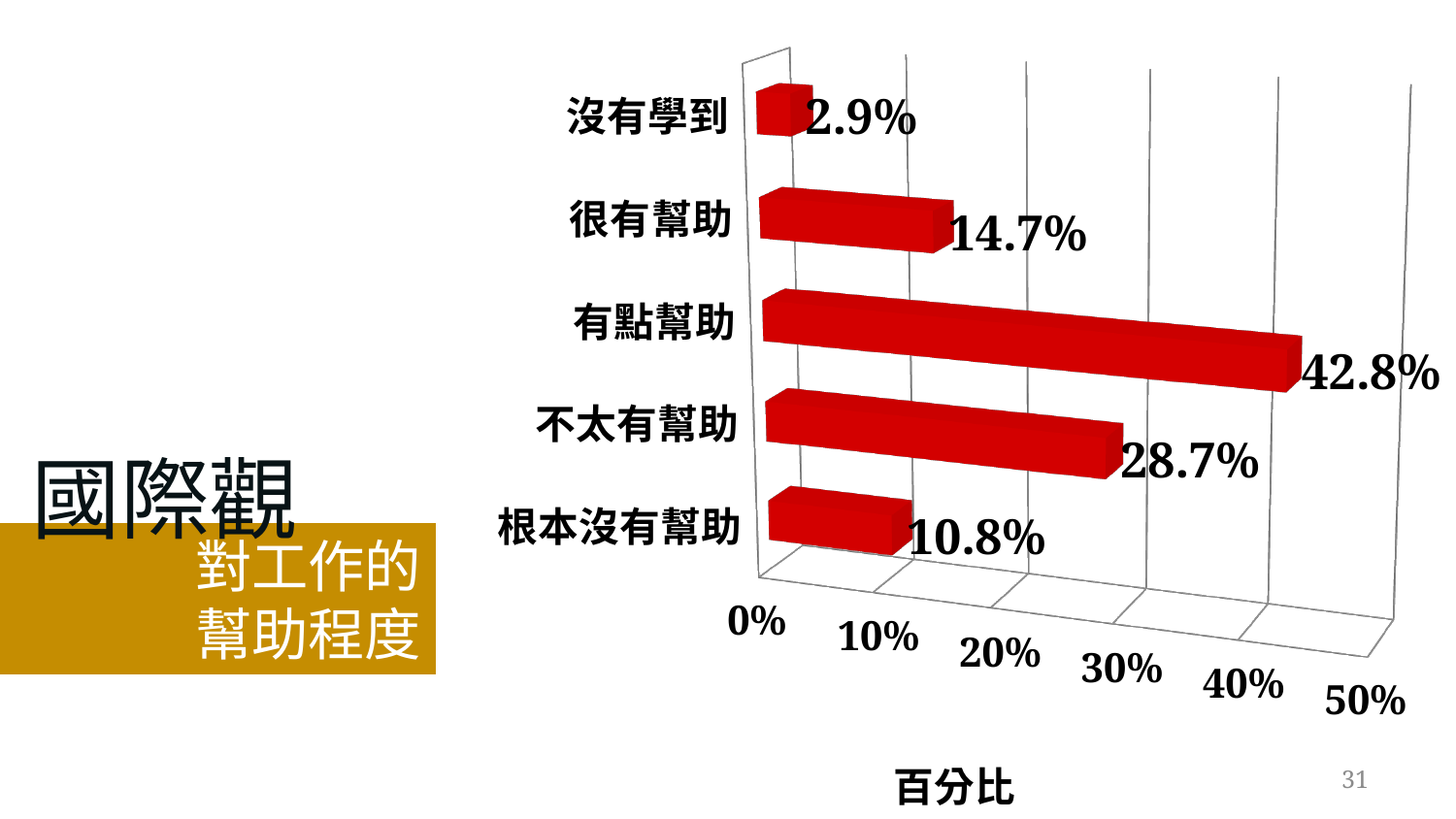
Which category has the lowest value? 沒有學到 How many categories are shown in the chart? 5 Is the value for 不太有幫助 greater or less than 20%? greater What is the value for 根本沒有幫助? 10.8% What is the difference between the values for 有點幫助 and 不太有幫助? 14.1% What is the value for 不太有幫助? 28.7% Which is larger, the value for 很有幫助 or the value for 根本沒有幫助? 很有幫助 What is the label of the horizontal axis? 百分比 What kind of chart is shown on the slide? bar chart What is the value for 沒有學到? 2.9% What is the value for 有點幫助? 42.8% Which category has the highest value? 有點幫助